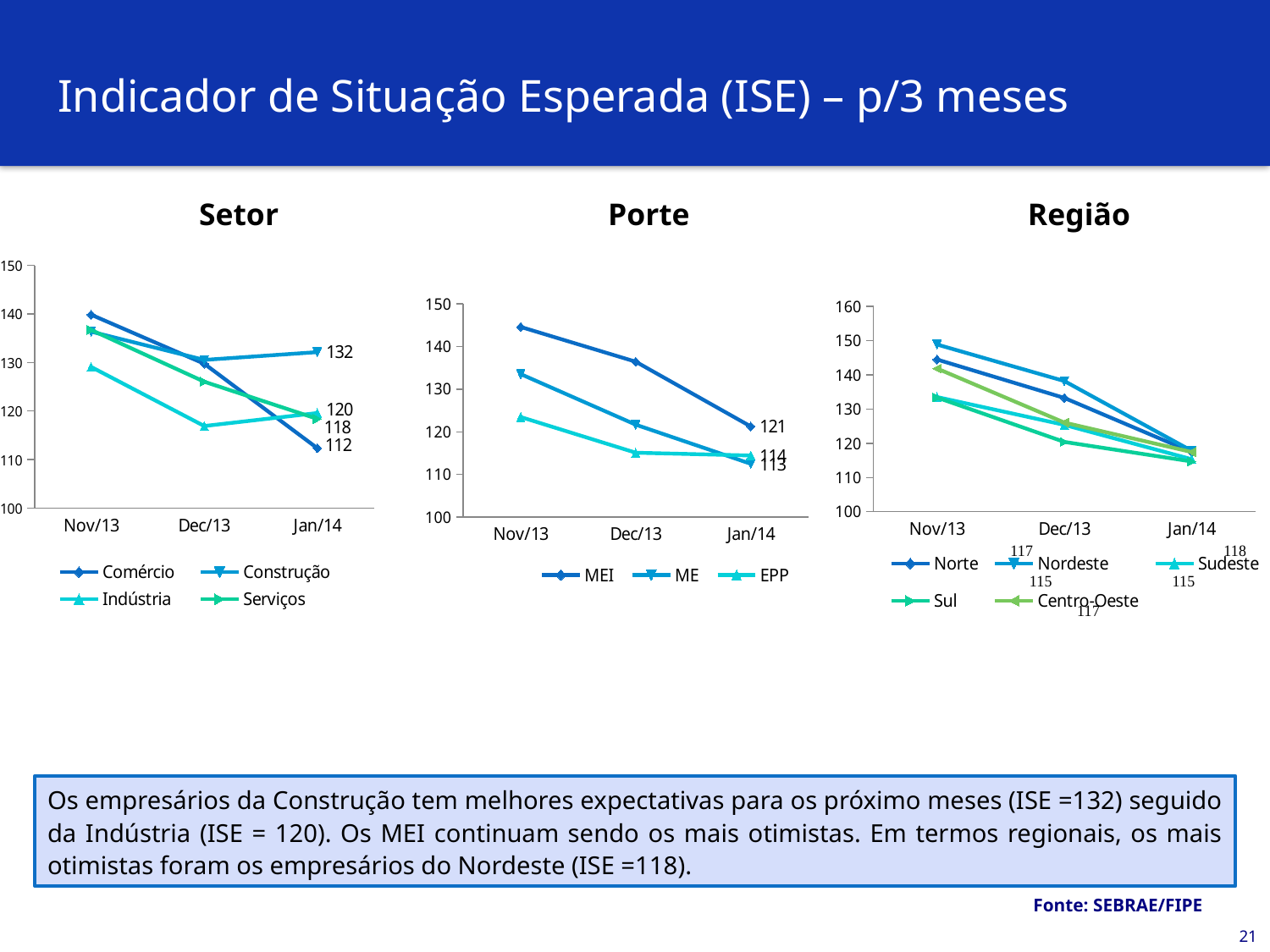
In the Porte chart, which series has the highest value in Jan/14? MEI In the Região chart, is the value for Norte in Nov/13 greater or less than 140? greater In the Porte chart, what is the value for MEI in Jan/14? 121 In the Setor chart, what is the value for Construção in Jan/14? 132 In the Setor chart, what is the difference between the Jan/14 values for Construção and Indústria? 12 In the Setor chart, what is the value for Comércio in Jan/14? 112 In the Setor chart, which series has the highest value in Jan/14? Construção In the Setor chart, what is the value for Indústria in Jan/14? 120 How many series does the legend of the Região chart list? 5 In the Setor chart, which series has the lowest value in Jan/14? Comércio In the Porte chart, does the MEI series rise or fall from Nov/13 to Jan/14? fall What kind of chart is the Porte chart? line chart